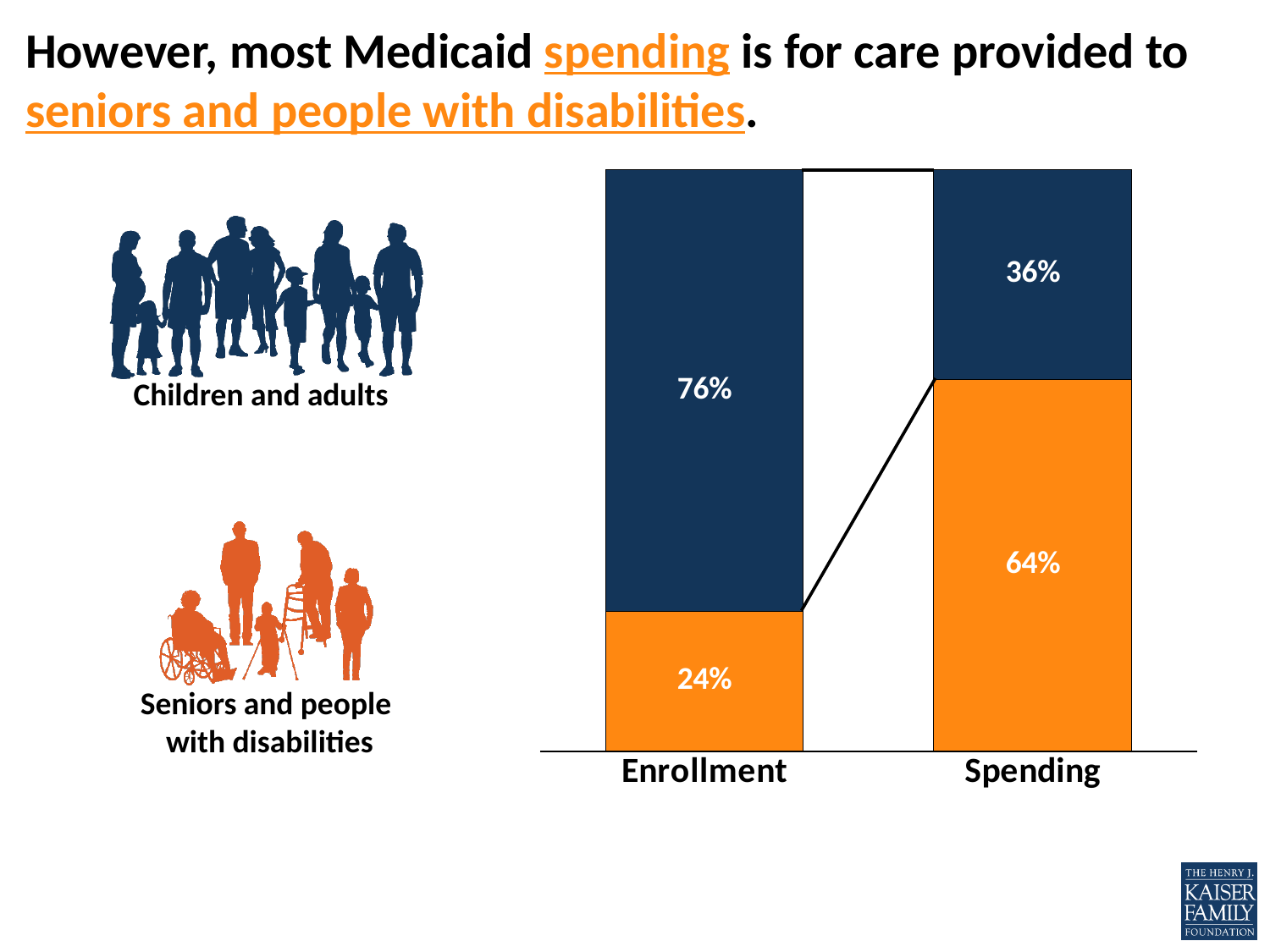
What share of Medicaid enrollment is seniors and people with disabilities? 24% What share of Medicaid enrollment is children and adults? 76% Which colour represents seniors and people with disabilities in the chart? Orange What kind of chart is shown on the slide? Stacked bar chart What share of Medicaid spending is for seniors and people with disabilities? 64% How many categories are shown on the x axis of the chart? 2 What is the difference between the spending share and the enrollment share for seniors and people with disabilities? 40 percentage points Which is larger: the enrollment share for children and adults or the spending share for children and adults? Enrollment share What share of Medicaid spending is for children and adults? 36% Which group has the smaller share of Medicaid enrollment? Seniors and people with disabilities What is the total of the Enrollment bar? 100% Which group has the larger share of Medicaid spending? Seniors and people with disabilities